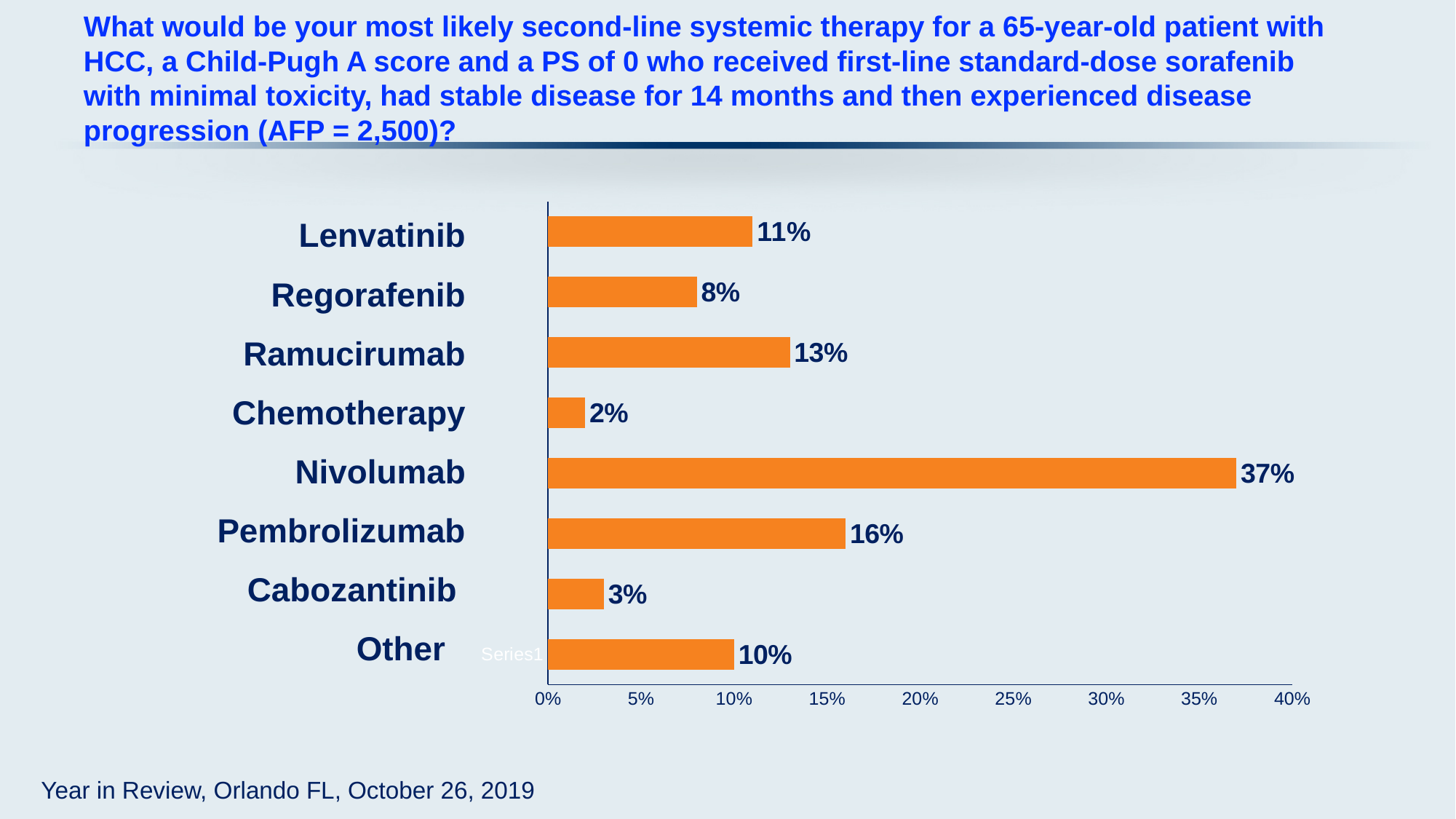
What is the maximum value shown on the x axis? 40% What is the difference between the values for Other and Regorafenib? 2% Is the value for Pembrolizumab greater or less than 15%? greater Which has a larger value, Lenvatinib or Regorafenib? Lenvatinib What is the difference between the percentages for Nivolumab and Pembrolizumab? 21% Which therapy has the lowest percentage? Chemotherapy Which therapy has the highest percentage? Nivolumab What is the value shown for Ramucirumab? 13% How many therapy categories are shown in the chart? 8 What percentage is shown for Cabozantinib? 3% What kind of chart is shown on the slide? Bar chart What percentage of respondents chose Nivolumab? 37%